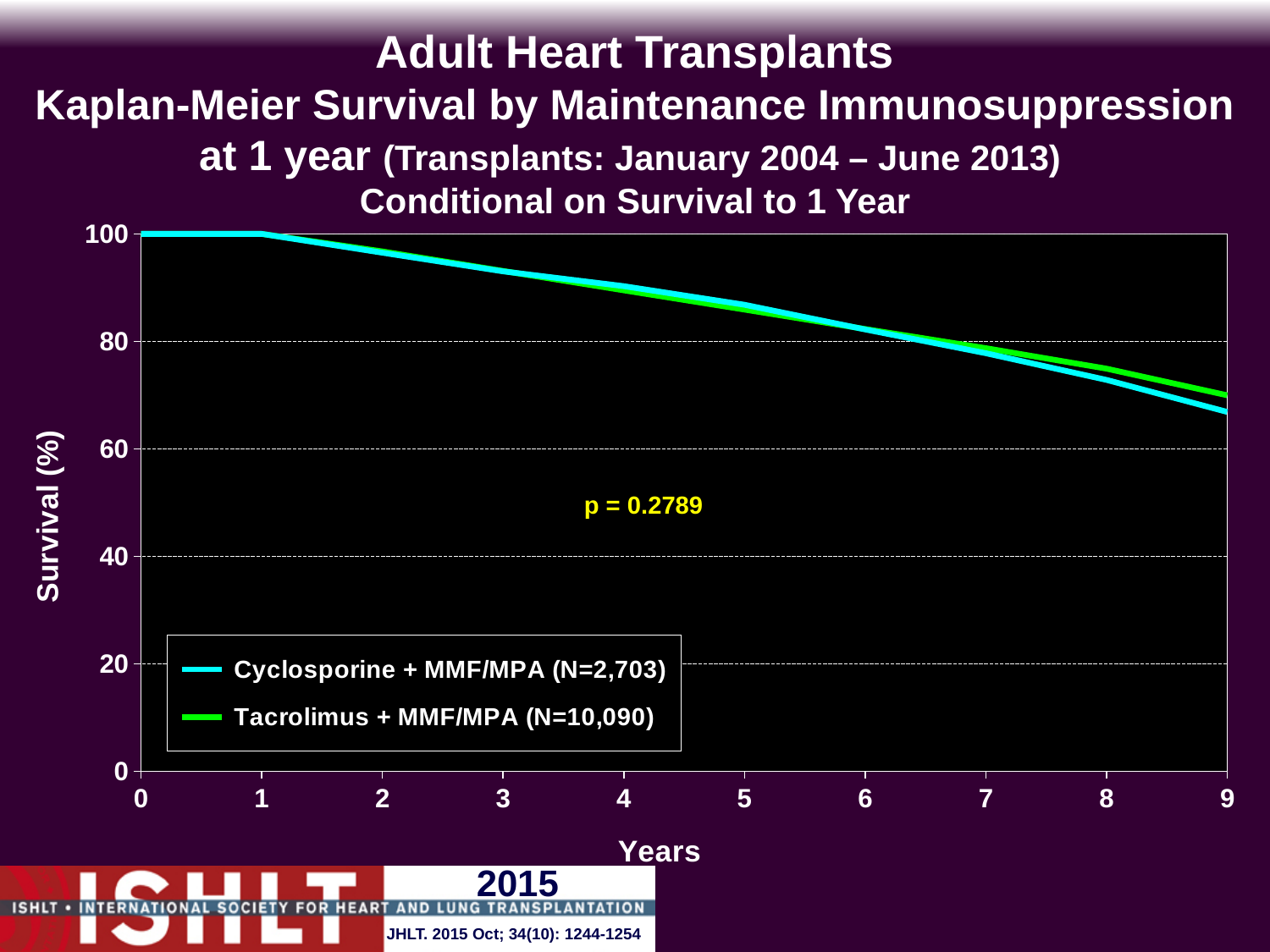
Is the survival value for Tacrolimus + MMF/MPA at year 5 greater or less than 80? greater What p-value is printed on the chart? p = 0.2789 What is the highest year shown on the x axis? 9 What is the N for the Tacrolimus + MMF/MPA group shown in the legend? 10,090 What kind of chart is shown on the slide? line chart Is the survival value for Tacrolimus + MMF/MPA at year 9 greater or less than 60? greater What is the survival value for both series at year 1? 100 How many series does the legend list? 2 At year 9, which series has the higher survival: Cyclosporine + MMF/MPA or Tacrolimus + MMF/MPA? Tacrolimus + MMF/MPA Is the survival value for Cyclosporine + MMF/MPA at year 9 greater or less than 80? less Do the survival curves rise or fall as the years increase along the x axis? fall